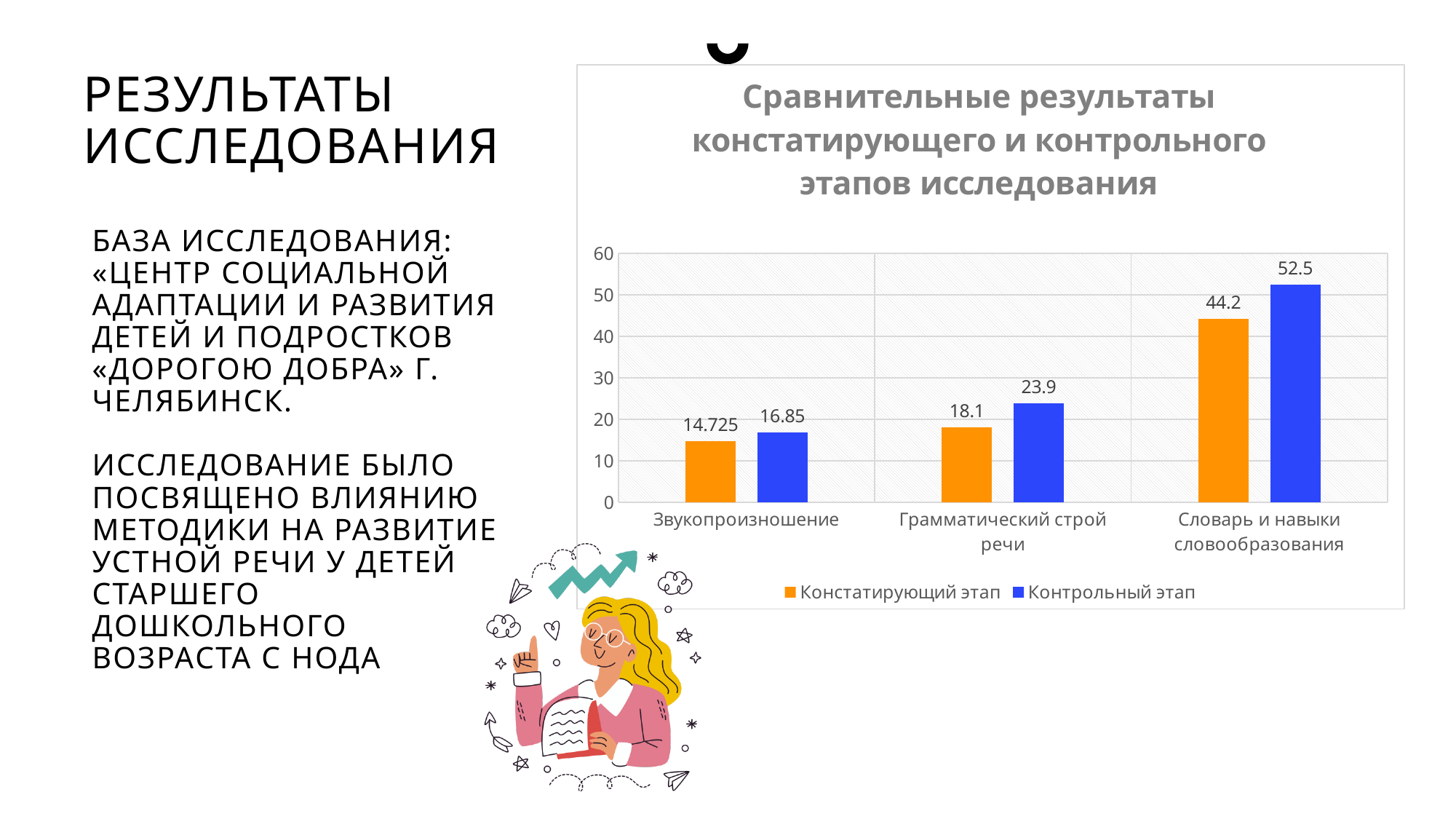
How many categories are shown on the x axis? 3 How many series does the legend list? 2 What is the difference between the Контрольный этап and Констатирующий этап values for Словарь и навыки словообразования? 8.3 What colour are the bars for the Контрольный этап series? blue Which category has the highest value in the Контрольный этап series? Словарь и навыки словообразования What is the value for Звукопроизношение in the Констатирующий этап series? 14.725 Which is larger for Звукопроизношение: the Констатирующий этап value or the Контрольный этап value? Контрольный этап What type of chart is shown on the slide? bar chart What is the difference between the Контрольный этап and Констатирующий этап values for Грамматический строй речи? 5.8 Which category has the lowest value in the Констатирующий этап series? Звукопроизношение What is the value for Грамматический строй речи in the Контрольный этап series? 23.9 What is the value for Словарь и навыки словообразования in the Констатирующий этап series? 44.2